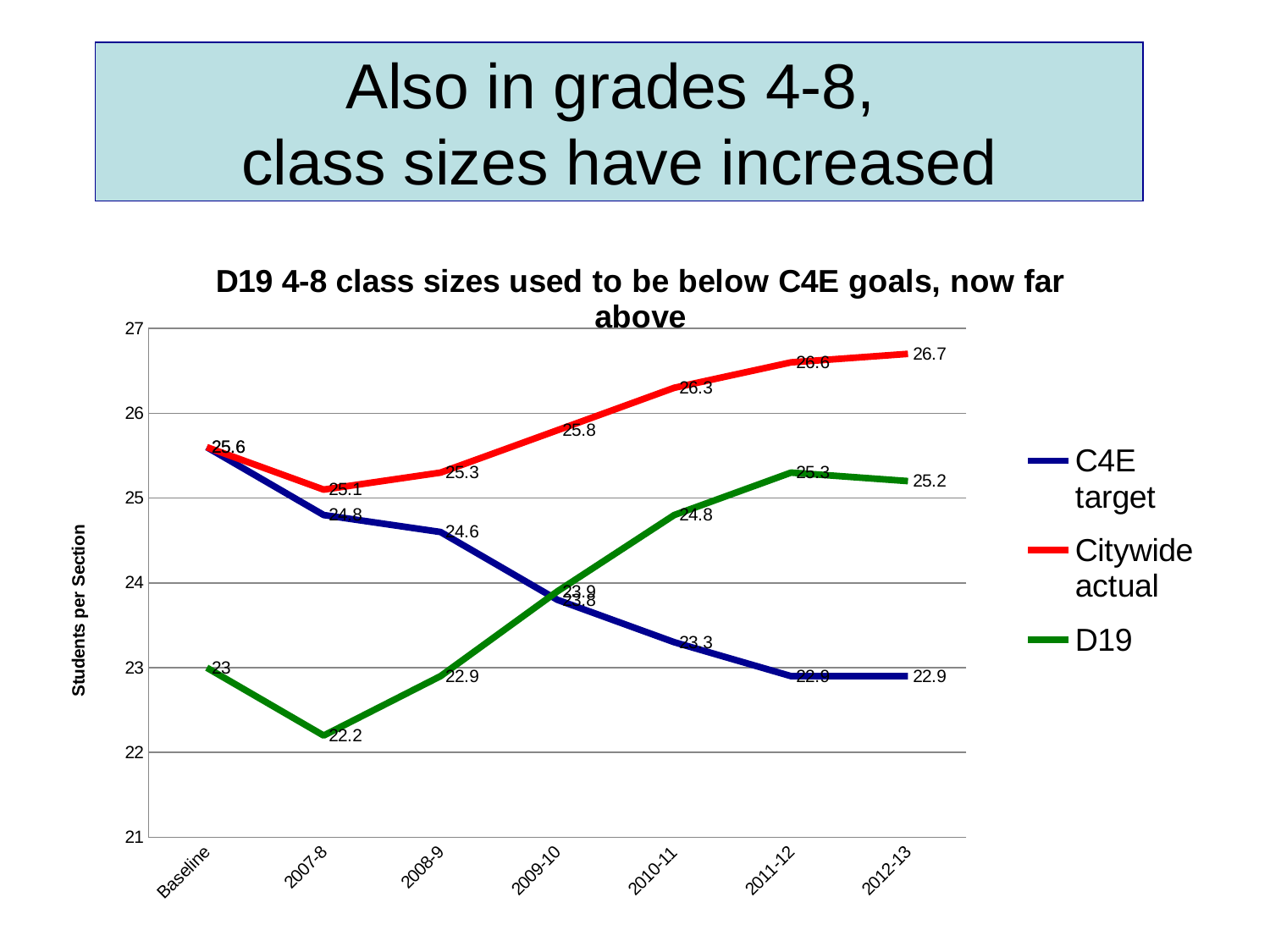
In which year does the Citywide actual series reach its highest value? 2012-13 Which is larger in 2010-11, the D19 value or the C4E target value? D19 Is the Citywide actual value for 2010-11 greater or less than 26? greater What is the difference between the Citywide actual value and the D19 value in 2012-13? 1.5 What is the C4E target value for 2010-11? 23.3 What is the Citywide actual value for 2012-13? 26.7 How many time points are plotted along the x axis? 7 Does the C4E target series rise or fall from Baseline to 2012-13? fall What is the Citywide actual value for 2009-10? 25.8 How many series does the legend list? 3 In which year is the D19 series at its lowest value? 2007-8 What is the D19 value for 2007-8? 22.2